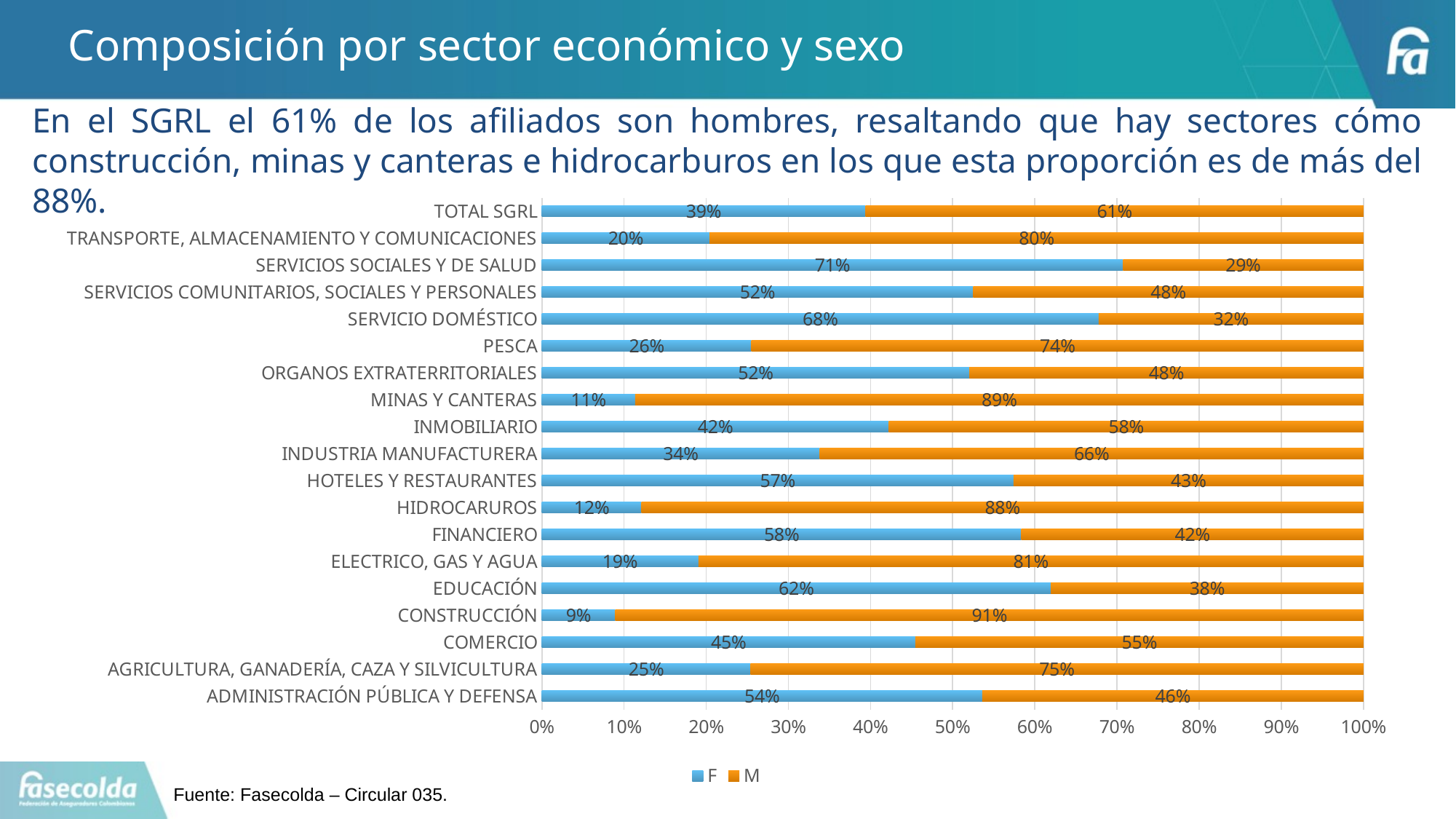
How many series does the legend list? 2 How many categories are shown on the chart? 19 What is the value of the F series for SERVICIOS SOCIALES Y DE SALUD? 71% What is the difference between the M value and the F value for HIDROCARUROS? 76% Which category has the highest value for the F series? SERVICIOS SOCIALES Y DE SALUD What kind of chart is shown on the slide? Stacked bar chart What is the value of the M series for CONSTRUCCIÓN? 91% What is the value of the F series for MINAS Y CANTERAS? 11% What is the value of the M series for TOTAL SGRL? 61% Which category has the lowest value for the F series? CONSTRUCCIÓN Which is larger, the F value for EDUCACIÓN or the F value for FINANCIERO? EDUCACIÓN What is the total of the stacked bar for COMERCIO? 100%